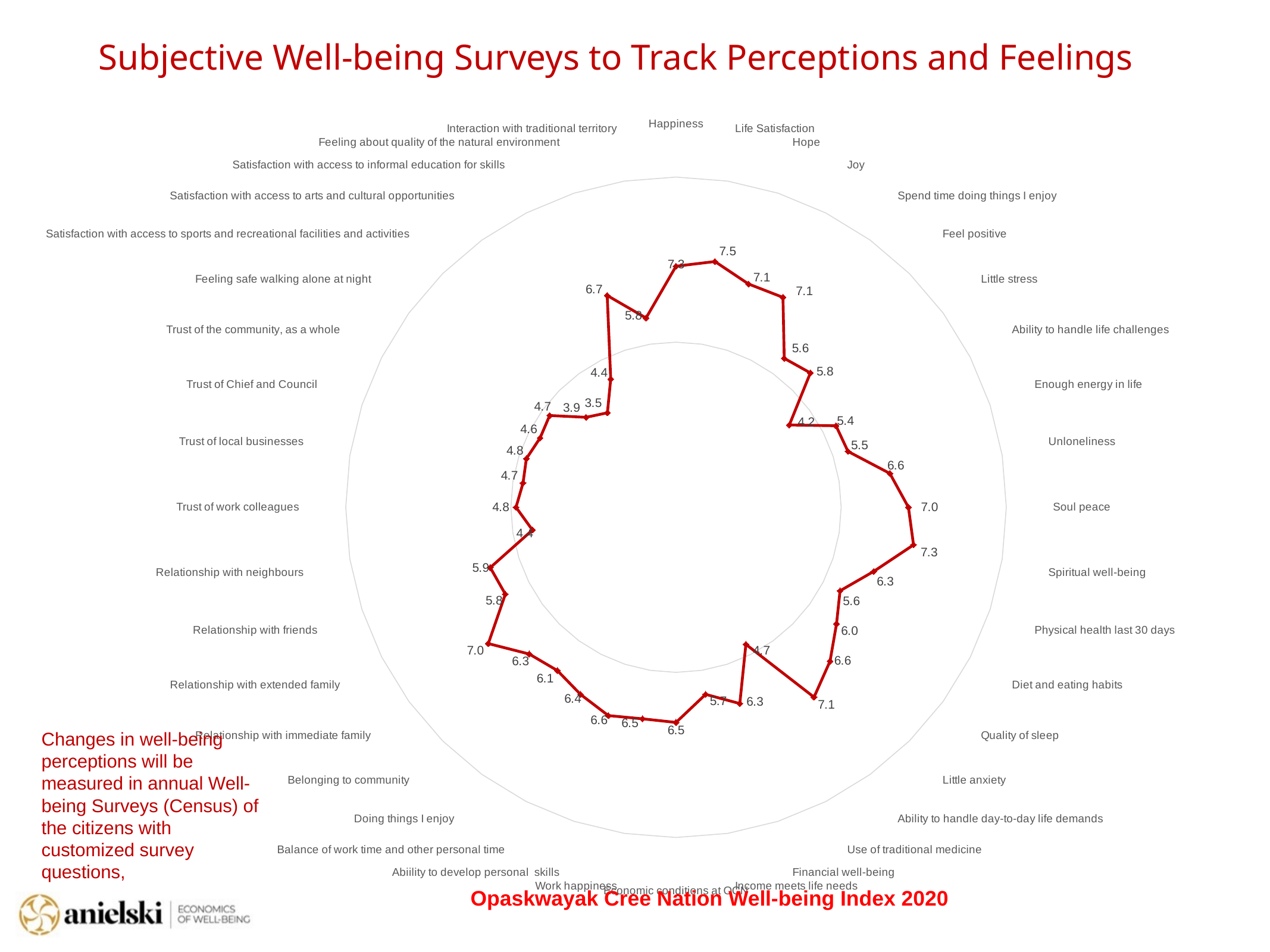
Which category has the highest value? Life Satisfaction Which category has the lowest value? Satisfaction with access to arts and cultural opportunities What kind of chart is shown on the slide? Radar chart What is the value for Spiritual well-being? 7.3 How many categories are plotted on the chart? 40 Which is larger, the value for Spiritual well-being or the value for Relationship with immediate family? Spiritual well-being What is the difference between the values for Spiritual well-being and Soul peace? 0.3 What is the value for Trust of work colleagues? 4.8 What is the value for Life Satisfaction? 7.5 What is the title shown beneath the chart? Opaskwayak Cree Nation Well-being Index 2020 What is the value for Economic conditions at OCN? 6.5 What is the value for Soul peace? 7.0